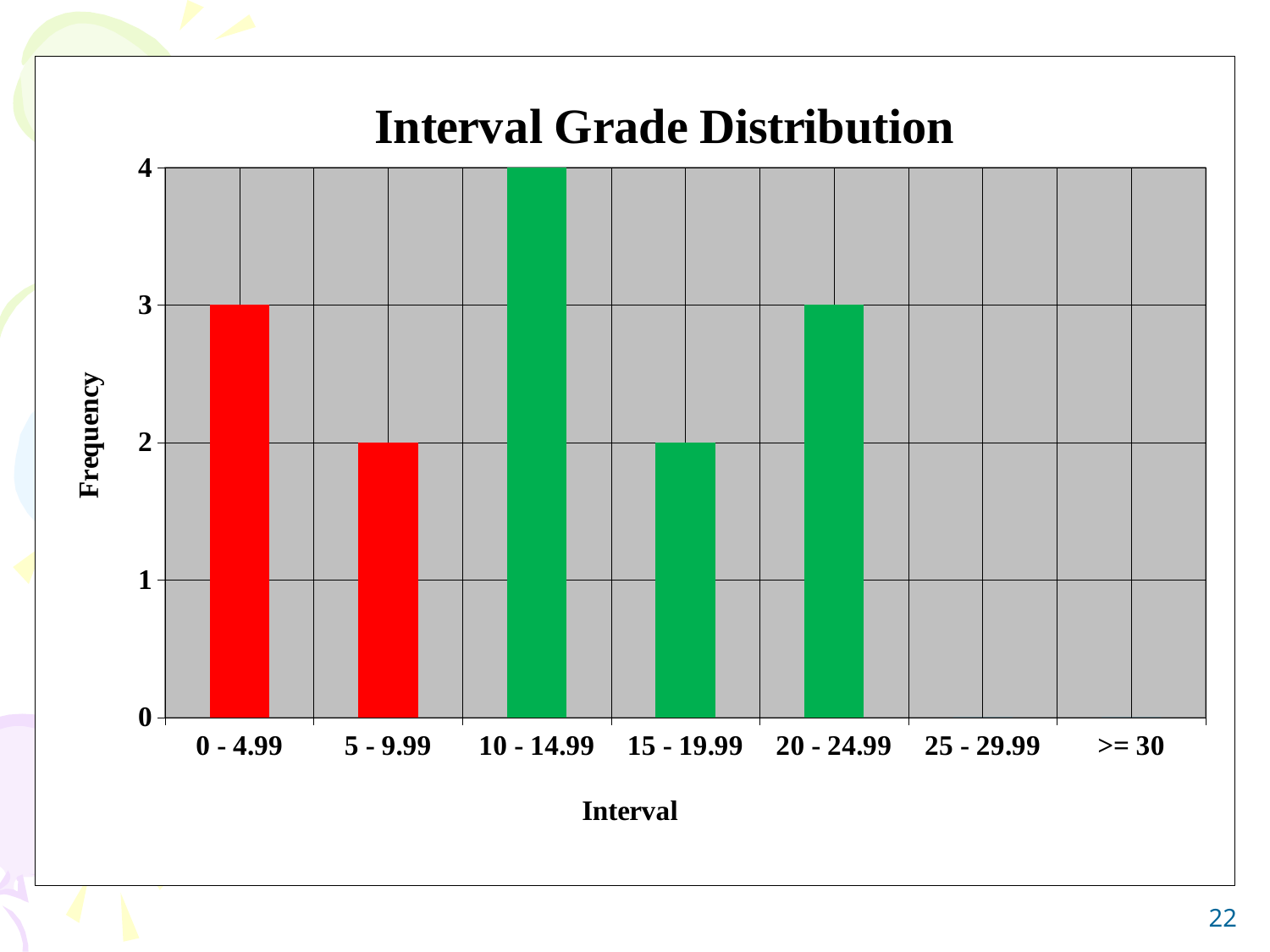
How many intervals are labelled on the x axis? 7 Which interval has the highest frequency? 10 - 14.99 What is the label of the y axis? Frequency What kind of chart is shown on the slide? bar chart What is the frequency for the 15 - 19.99 interval? 2 What is the frequency for the 10 - 14.99 interval? 4 How many intervals have a frequency of 0? 2 What is the frequency for the 0 - 4.99 interval? 3 What is the difference in frequency between the 10 - 14.99 interval and the 5 - 9.99 interval? 2 Is the frequency for the 20 - 24.99 interval greater or less than 2? greater What is the title of the chart? Interval Grade Distribution Which has a higher frequency, the 0 - 4.99 interval or the 15 - 19.99 interval? 0 - 4.99